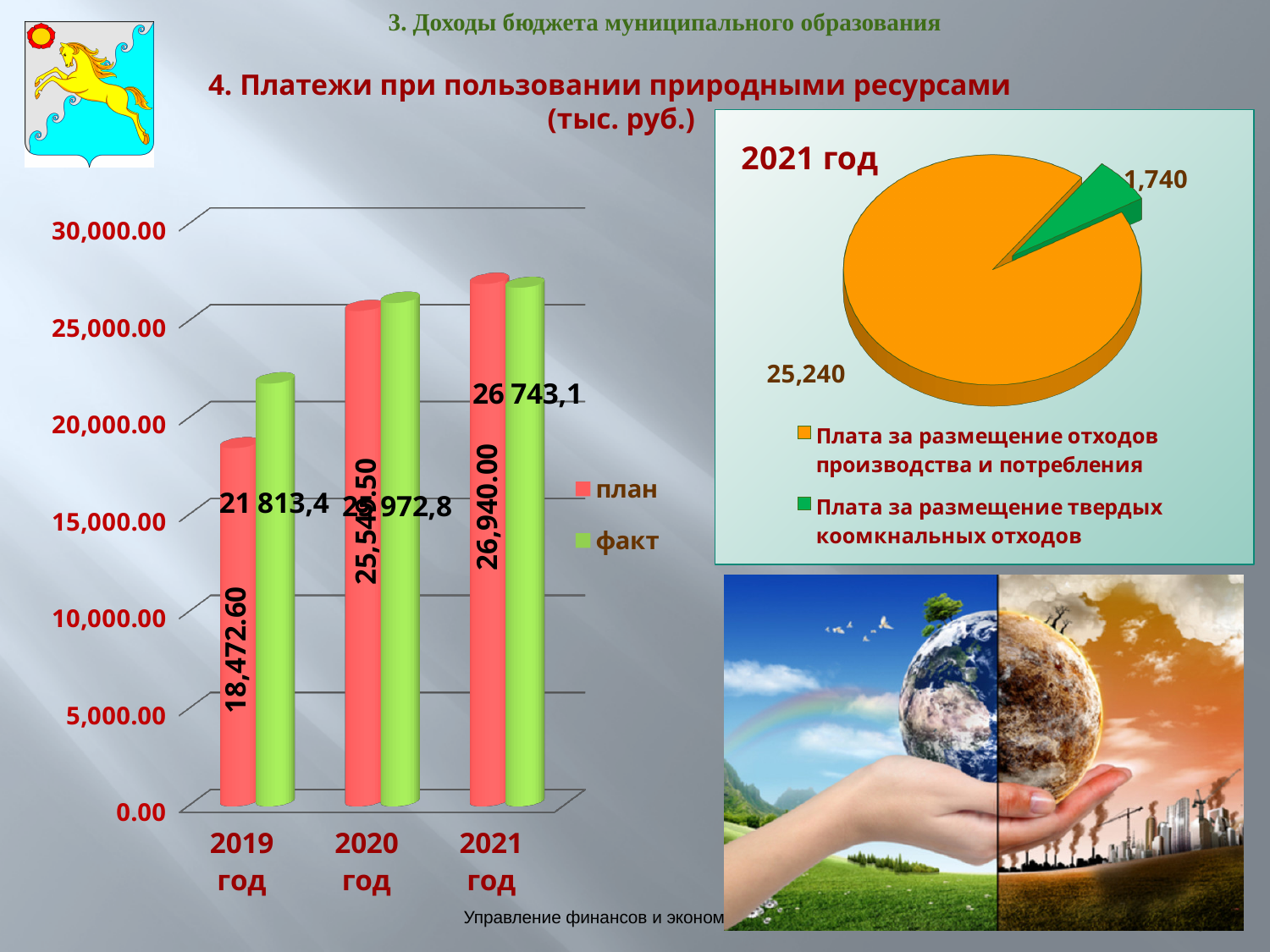
In the pie chart for 2021 год, which category has the largest slice? Плата за размещение отходов производства и потребления In the bar chart, what is the value of план for 2021 год? 26,940.00 In the bar chart, what is the value of план for 2019 год? 18,472.60 In the bar chart, what is the value of факт for 2021 год? 26 743,1 In the bar chart, which is larger for 2019 год, план or факт? факт In the pie chart for 2021 год, what is the value for Плата за размещение твердых коммунальных отходов? 1,740 In the bar chart, is the value of план for 2020 год greater or less than 25,000.00? greater In the bar chart, does the факт series rise or fall from 2019 год to 2021 год? rises How many series does the legend of the bar chart list? 2 In the bar chart, what is the value of факт for 2020 год? 25 972,8 In the bar chart, which is larger for 2021 год, план or факт? план In the bar chart, what is the value of факт for 2019 год? 21 813,4